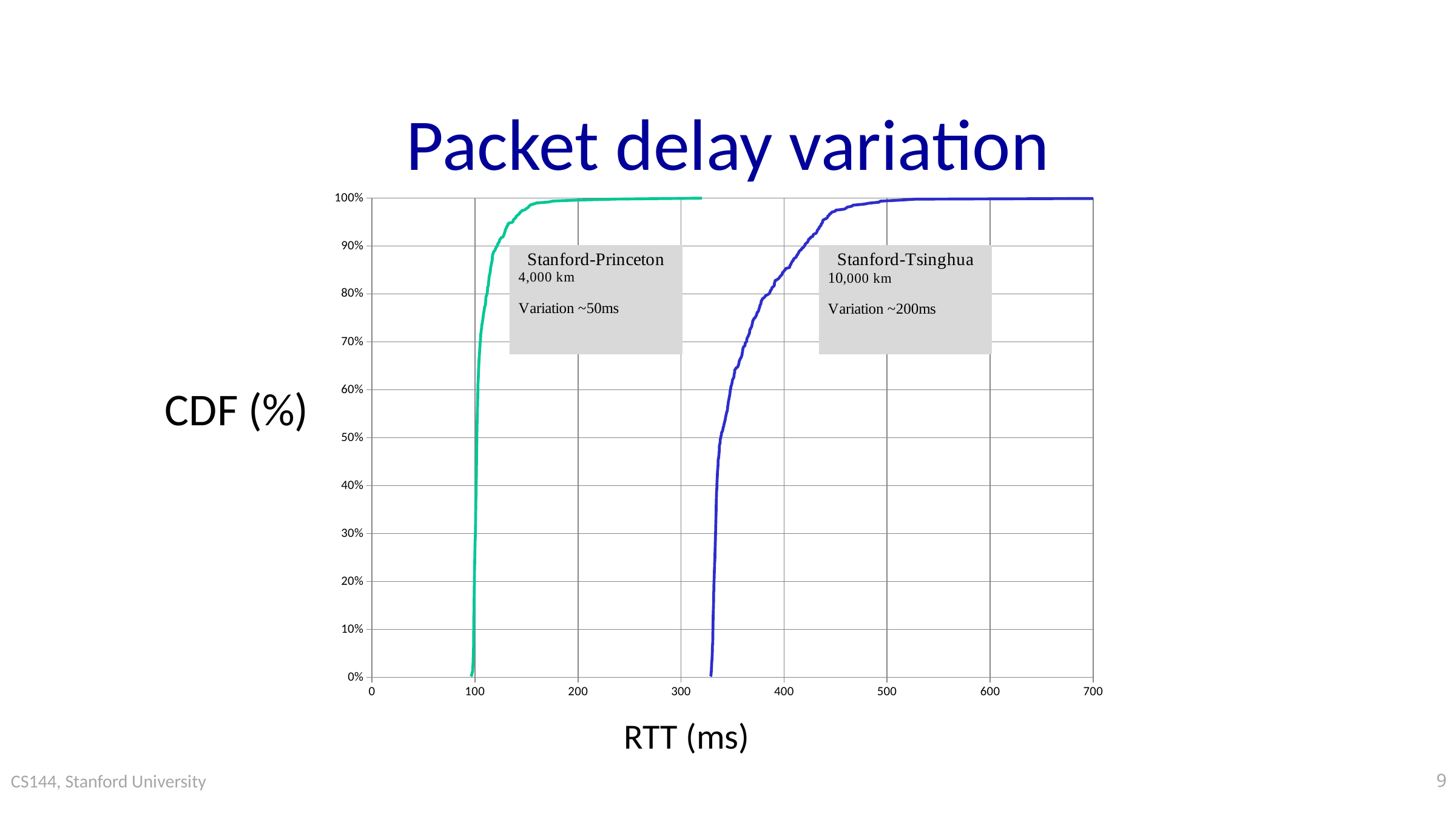
What distance is given for the Stanford-Princeton path? 4,000 km Is the Stanford-Princeton CDF value at an RTT of 200 ms greater or less than 90%? greater Is the Stanford-Tsinghua CDF value at an RTT of 350 ms greater or less than 80%? less What is the label of the x axis? RTT (ms) What is the title of the chart? Packet delay variation Which path has the larger stated delay variation, Stanford-Princeton or Stanford-Tsinghua? Stanford-Tsinghua What kind of chart is shown on the slide? Line chart What distance is given for the Stanford-Tsinghua path? 10,000 km What variation is stated for the Stanford-Tsinghua curve? Variation ~200ms Which curve reaches 50% CDF at a lower RTT, Stanford-Princeton or Stanford-Tsinghua? Stanford-Princeton What variation is stated for the Stanford-Princeton curve? Variation ~50ms How many curves are plotted on the chart? 2